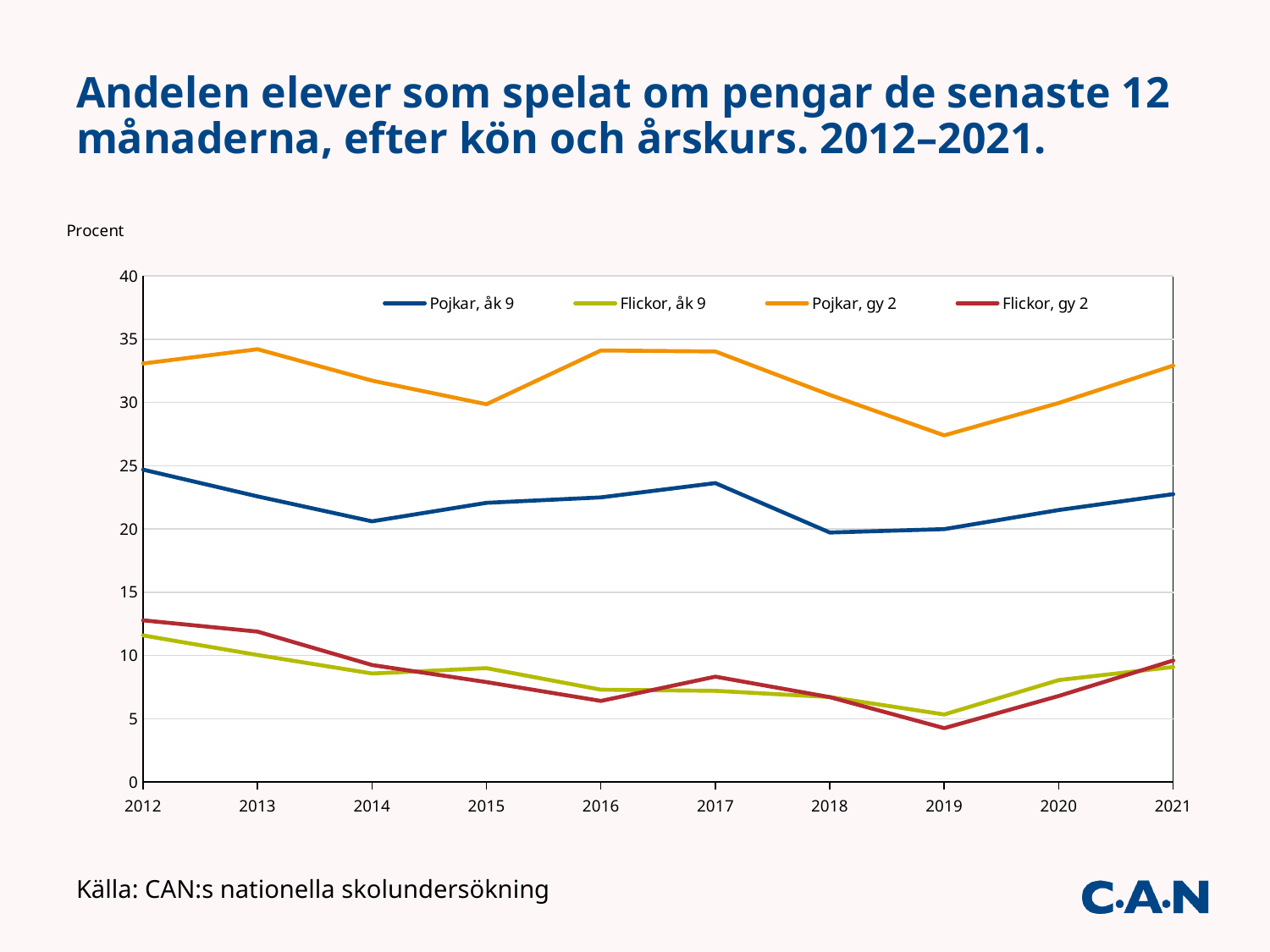
In which year is the value for Flickor, gy 2 lowest? 2019 How many years are shown along the x axis? 10 In 2012, which is larger: Pojkar, gy 2 or Pojkar, åk 9? Pojkar, gy 2 In which year is the value for Pojkar, gy 2 lowest? 2019 In which year is the value for Pojkar, åk 9 highest? 2012 What unit label is shown above the y axis? Procent What kind of chart is shown on the slide? line chart How many series does the legend list? 4 Does the value for Pojkar, gy 2 rise or fall from 2017 to 2019? fall Is the value for Pojkar, åk 9 in 2012 greater or less than 20? greater Is the value for Flickor, åk 9 in 2019 greater or less than 10? less Is the value for Pojkar, gy 2 in 2019 greater or less than 30? less